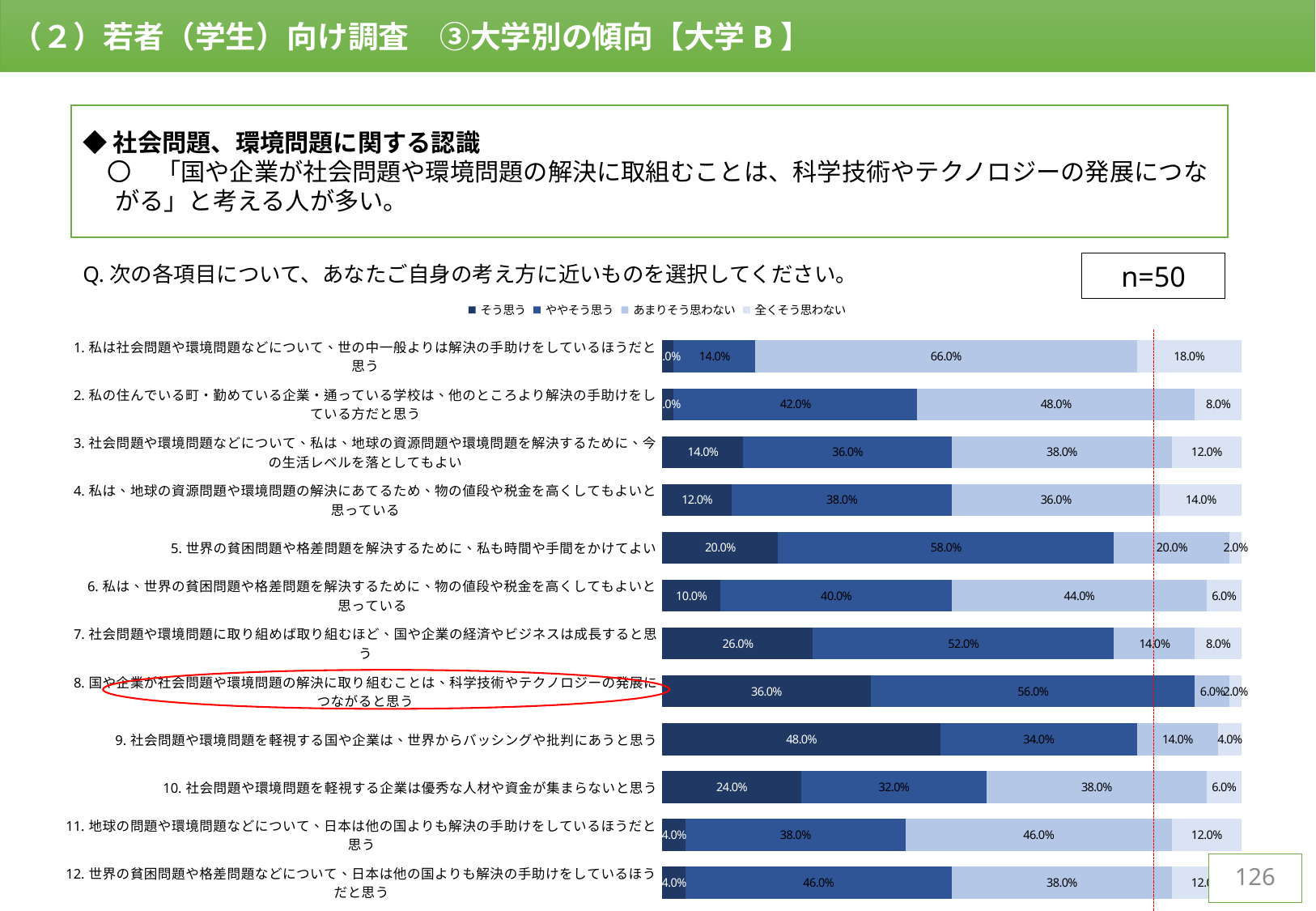
What sample size (n) is shown on the slide? n=50 What kind of chart is shown on the slide? Stacked bar chart What is the total of the four segments for item 8? 100.0% Which item has the highest 「全くそう思わない」 value? 1. 私は社会問題や環境問題などについて、世の中一般よりは解決の手助けをしているほうだと思う How many series does the chart legend list? 4 How many items (categories) are plotted in the chart? 12 What is the difference between the 「ややそう思う」 values of item 8 (56.0%) and item 9 (34.0%)? 22.0% What is the 「あまりそう思わない」 value for item 1 (私は社会問題や環境問題などについて、世の中一般よりは解決の手助けをしているほうだと思う)? 66.0% What is the 「そう思う」 value for item 8 (国や企業が社会問題や環境問題の解決に取り組むことは、科学技術やテクノロジーの発展につながると思う)? 36.0% What is the 「ややそう思う」 value for item 5 (世界の貧困問題や格差問題を解決するために、私も時間や手間をかけてよい)? 58.0% Which is larger: the 「そう思う」 value for item 7 or for item 10? Item 7 (26.0%) Which item has the highest 「そう思う」 value? 9. 社会問題や環境問題を軽視する国や企業は、世界からバッシングや批判にあうと思う